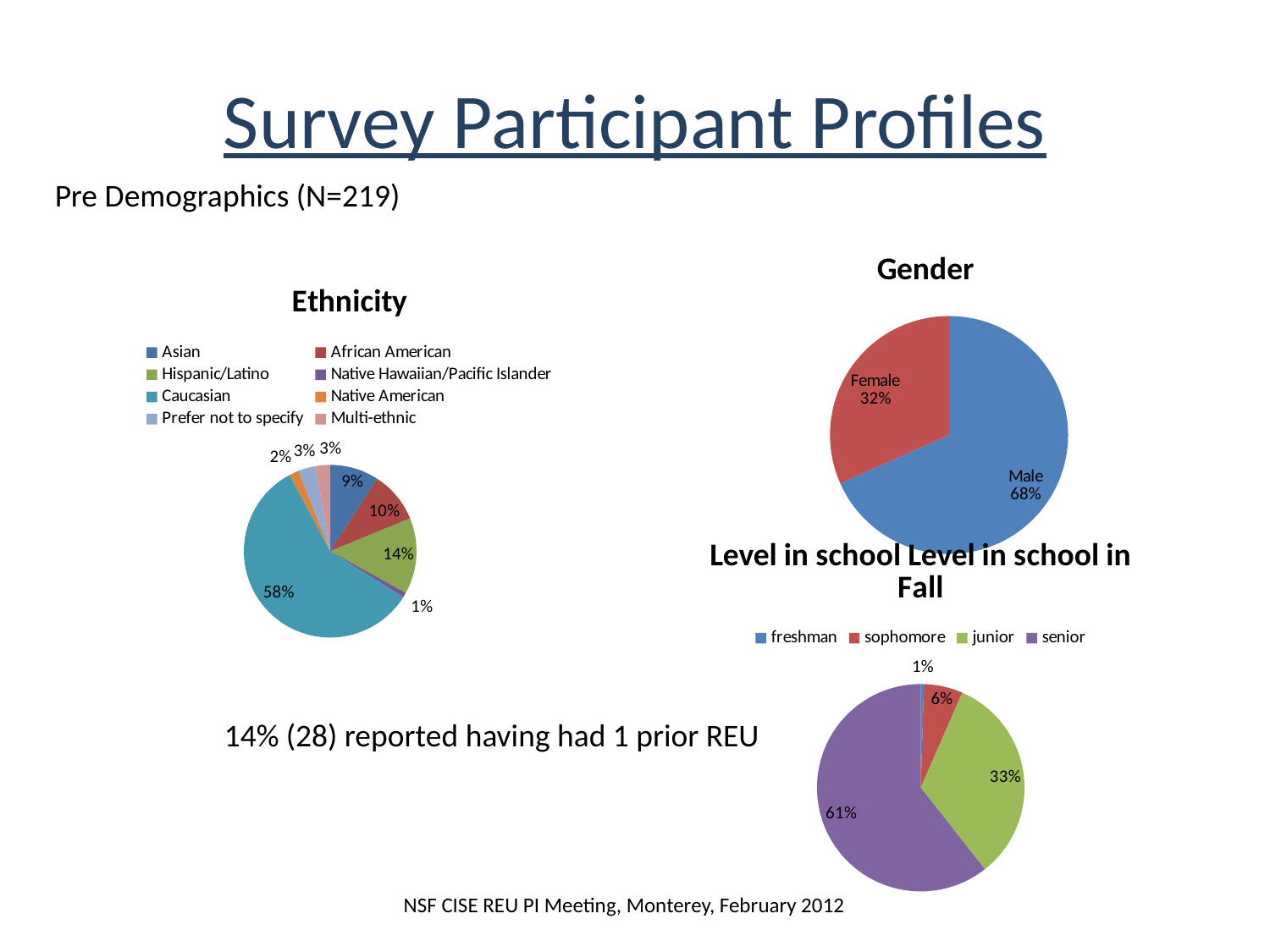
In the Ethnicity chart, what percentage of participants are Hispanic/Latino? 14% What type of chart is the Gender chart? Pie chart In the Gender chart, what percentage of participants are Female? 32% In the Level in school in Fall chart, what percentage of participants are juniors? 33% In the Ethnicity chart, which ethnicity has the largest share? Caucasian In the Gender chart, what percentage of participants are Male? 68% In the Ethnicity chart, what is the difference in percentage points between African American and Asian participants? 1% In the Level in school in Fall chart, what percentage of participants are seniors? 61% In the Ethnicity chart, what percentage of participants are Caucasian? 58% In the Level in school in Fall chart, which level has the smallest share? freshman In the Level in school in Fall chart, what is the difference in percentage points between seniors and juniors? 28% In the Ethnicity chart, how many ethnicity categories does the legend list? 8